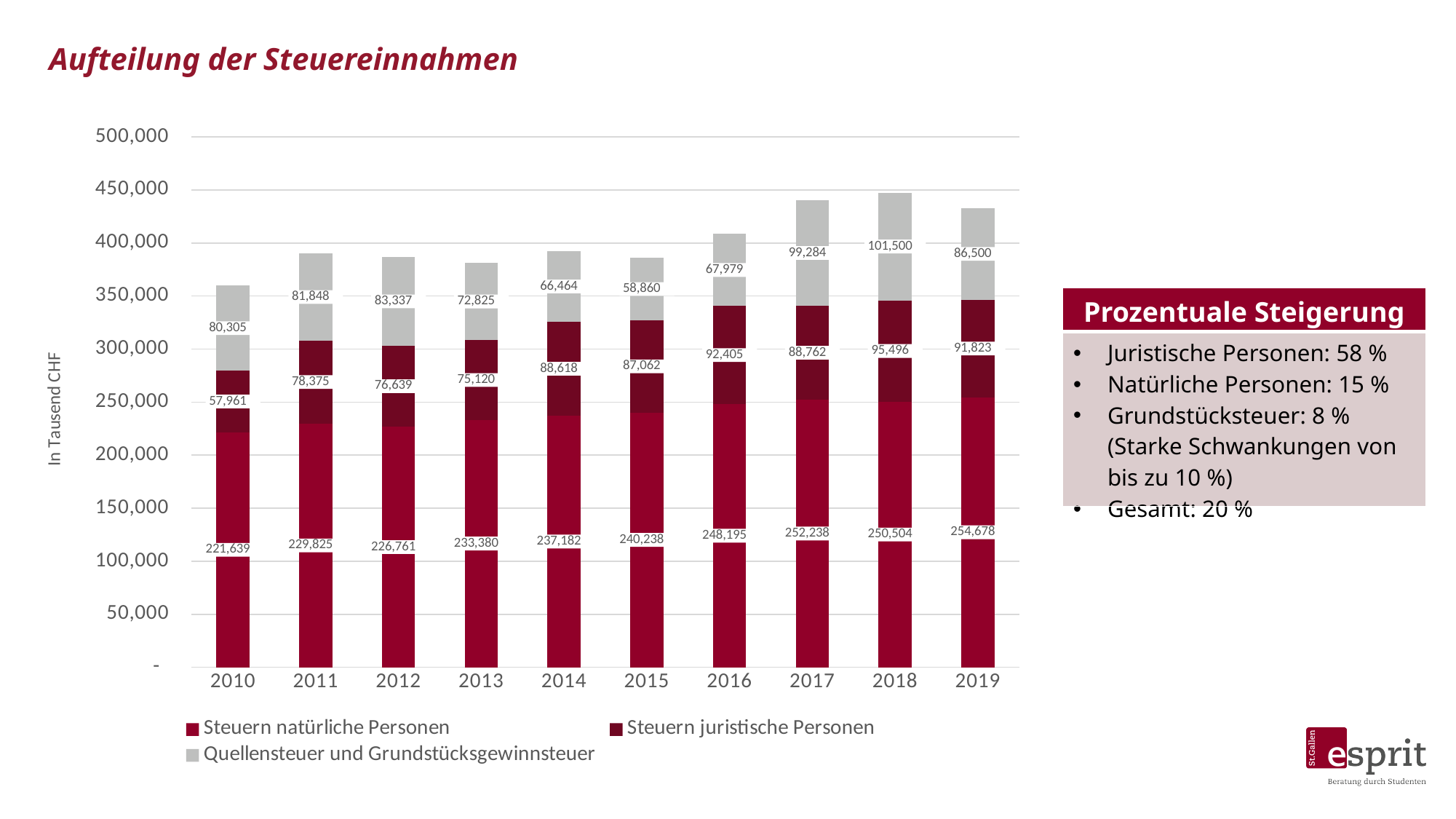
In which year is Quellensteuer und Grundstücksgewinnsteuer highest? 2018 What is the value for Steuern juristische Personen in 2017? 88,762 How many series does the legend list? 3 How many years are shown on the x axis? 10 What kind of chart is shown on the slide? Stacked bar chart Is the total of the stacked bar for 2018 greater or less than 400,000? greater What is the value for Steuern natürliche Personen in 2015? 240,238 What is the difference between Steuern natürliche Personen in 2019 and in 2010? 33,039 Which is larger: Steuern juristische Personen in 2018 or in 2019? 2018 What is the total of the stacked bar for 2010? 359,905 What is the value for Quellensteuer und Grundstücksgewinnsteuer in 2013? 72,825 In which year is Steuern juristische Personen lowest? 2010